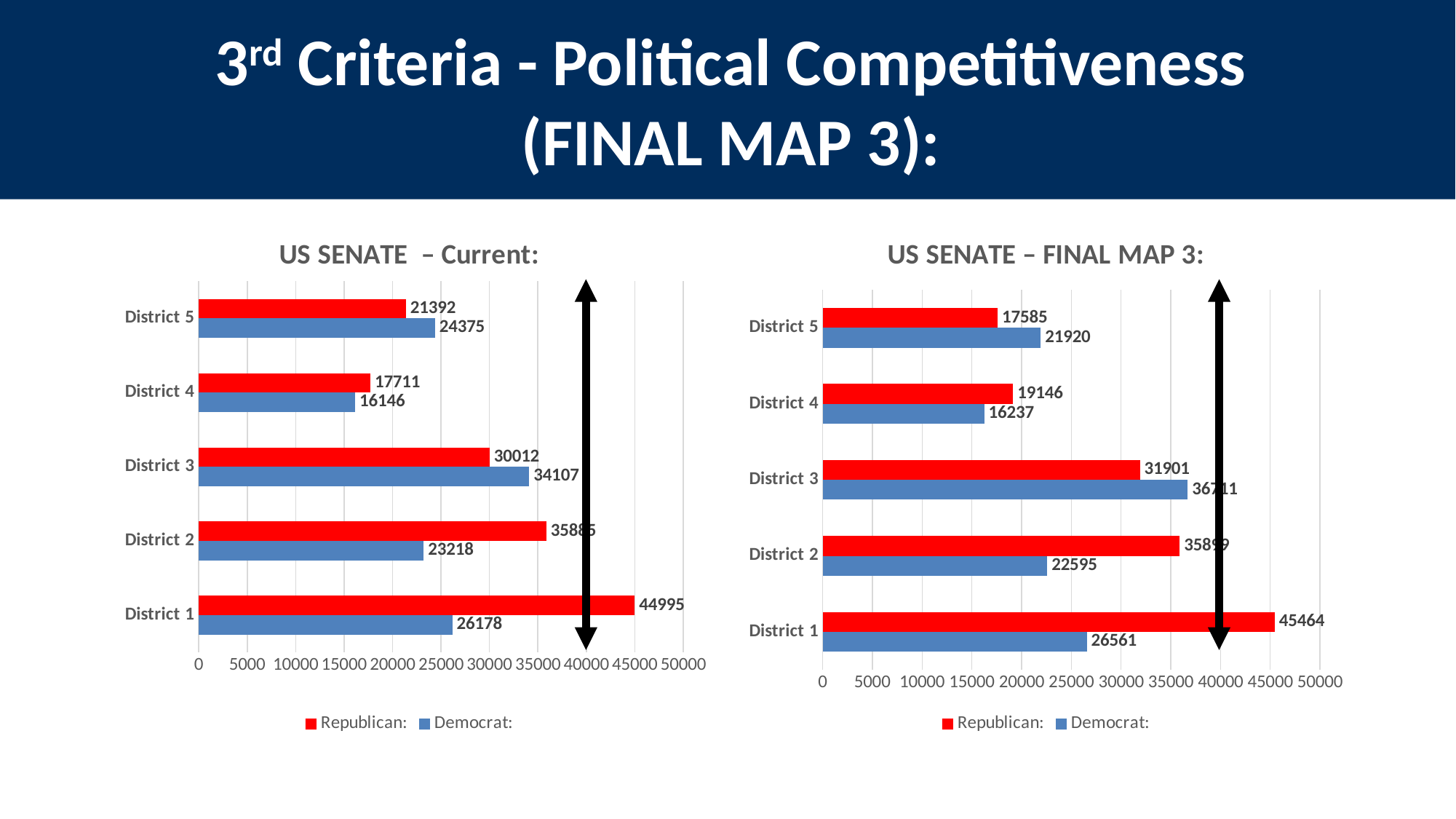
In the US SENATE – FINAL MAP 3 chart, is the Republican value for District 1 greater or less than 40000? greater In the US SENATE – FINAL MAP 3 chart, what is the Democrat value for District 5? 21920 In the US SENATE – Current chart, which district has the highest Republican value? District 1 In the US SENATE – FINAL MAP 3 chart, what is the Republican value for District 4? 19146 In the US SENATE – Current chart, what is the Republican value for District 1? 44995 In the US SENATE – Current chart, what is the difference between the Republican and Democrat values for District 1? 18817 How many series does the legend of the US SENATE – FINAL MAP 3 chart list? 2 How many districts are shown in the US SENATE – Current chart? 5 In the US SENATE – FINAL MAP 3 chart, which district has the lowest Democrat value? District 4 In the US SENATE – Current chart, is the Republican or Democrat value larger for District 4? Republican In the US SENATE – Current chart, what is the Democrat value for District 3? 34107 In the US SENATE – FINAL MAP 3 chart, what is the difference between the Democrat and Republican values for District 5? 4335